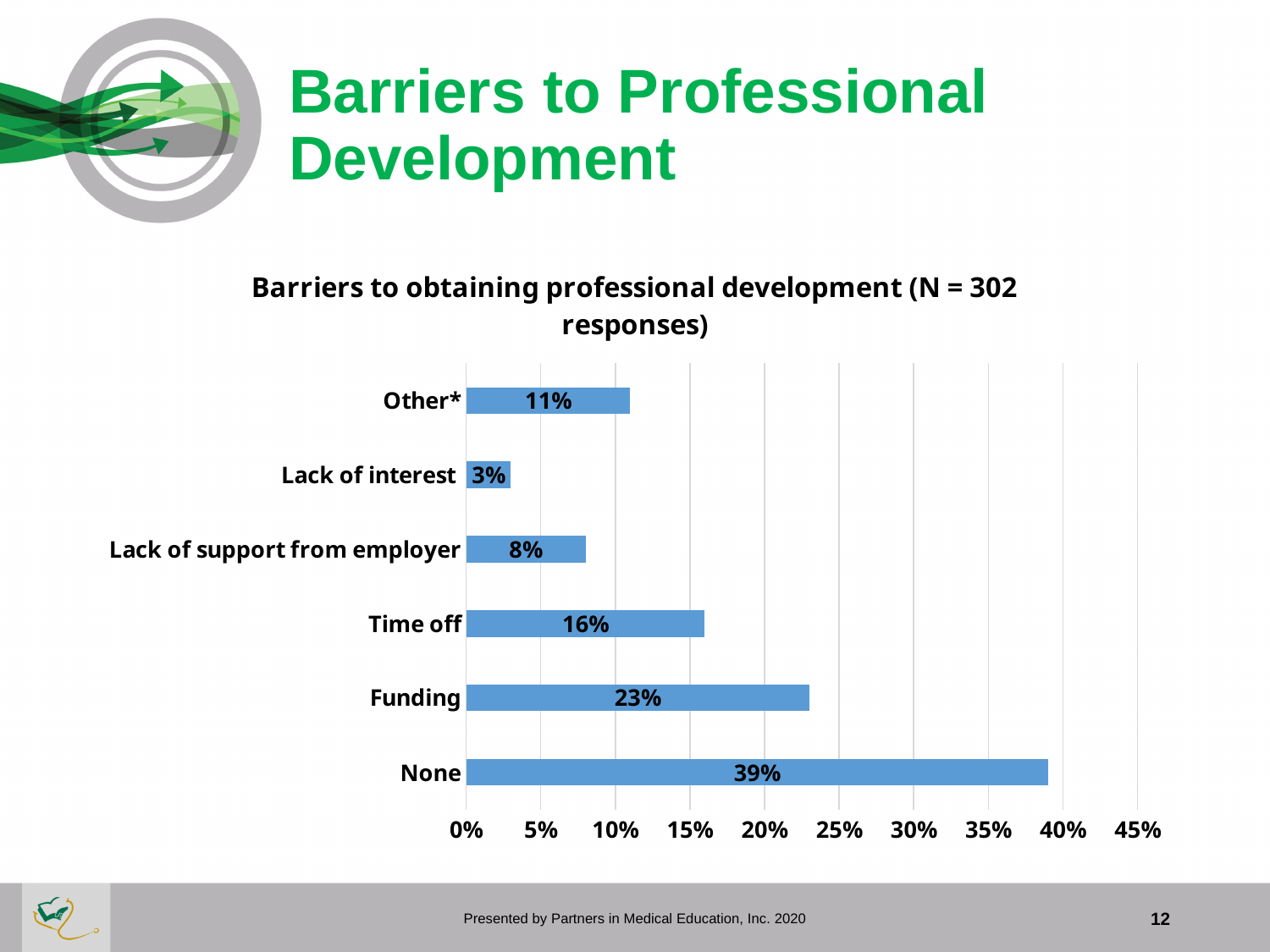
Is the value for Funding greater or less than 20%? greater What percentage of responses cited Funding as a barrier to obtaining professional development? 23% Which has a larger value, Time off or Other*? Time off How many responses (N) does the chart title say the data is based on? 302 What is the value shown for Lack of support from employer? 8% What kind of chart is used to show the barriers to obtaining professional development? Bar chart What is the difference in percentage points between None and Funding? 16% How many barrier categories are shown in the chart? 6 Which barrier category has the lowest percentage of responses? Lack of interest What is the difference in percentage points between Other* and Lack of interest? 8% Which barrier category has the highest percentage of responses? None What is the value shown for Time off? 16%